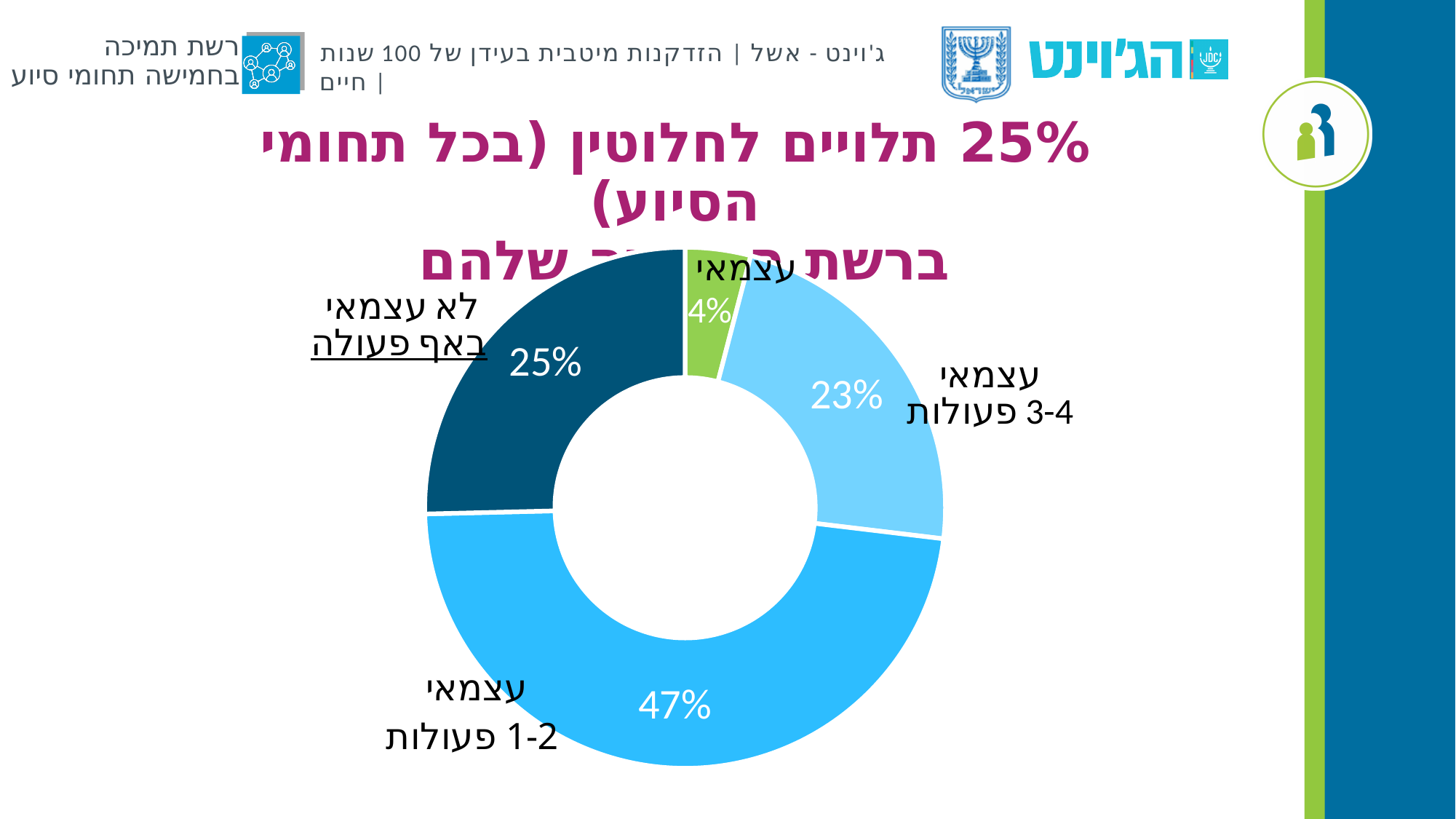
Which segment has the largest share of the chart? עצמאי 1-2 פעולות Which is larger: the share for "לא עצמאי באף פעולה" or the share for "עצמאי 3-4 פעולות"? לא עצמאי באף פעולה What percentage is shown for the segment labelled "לא עצמאי באף פעולה"? 25% How many segments does the chart have? 4 What percentage is shown for the green segment labelled "עצמאי"? 4% Which segment has the smallest share of the chart? עצמאי What is the difference in percentage points between "עצמאי 1-2 פעולות" and "לא עצמאי באף פעולה"? 22 What is the combined percentage of the two segments labelled "עצמאי 1-2 פעולות" and "עצמאי 3-4 פעולות"? 70% What colour is the segment labelled "לא עצמאי באף פעולה"? Dark blue What percentage is shown for the segment labelled "עצמאי 1-2 פעולות"? 47% What percentage is shown for the segment labelled "עצמאי 3-4 פעולות"? 23% What kind of chart is shown on the slide? Donut (pie) chart